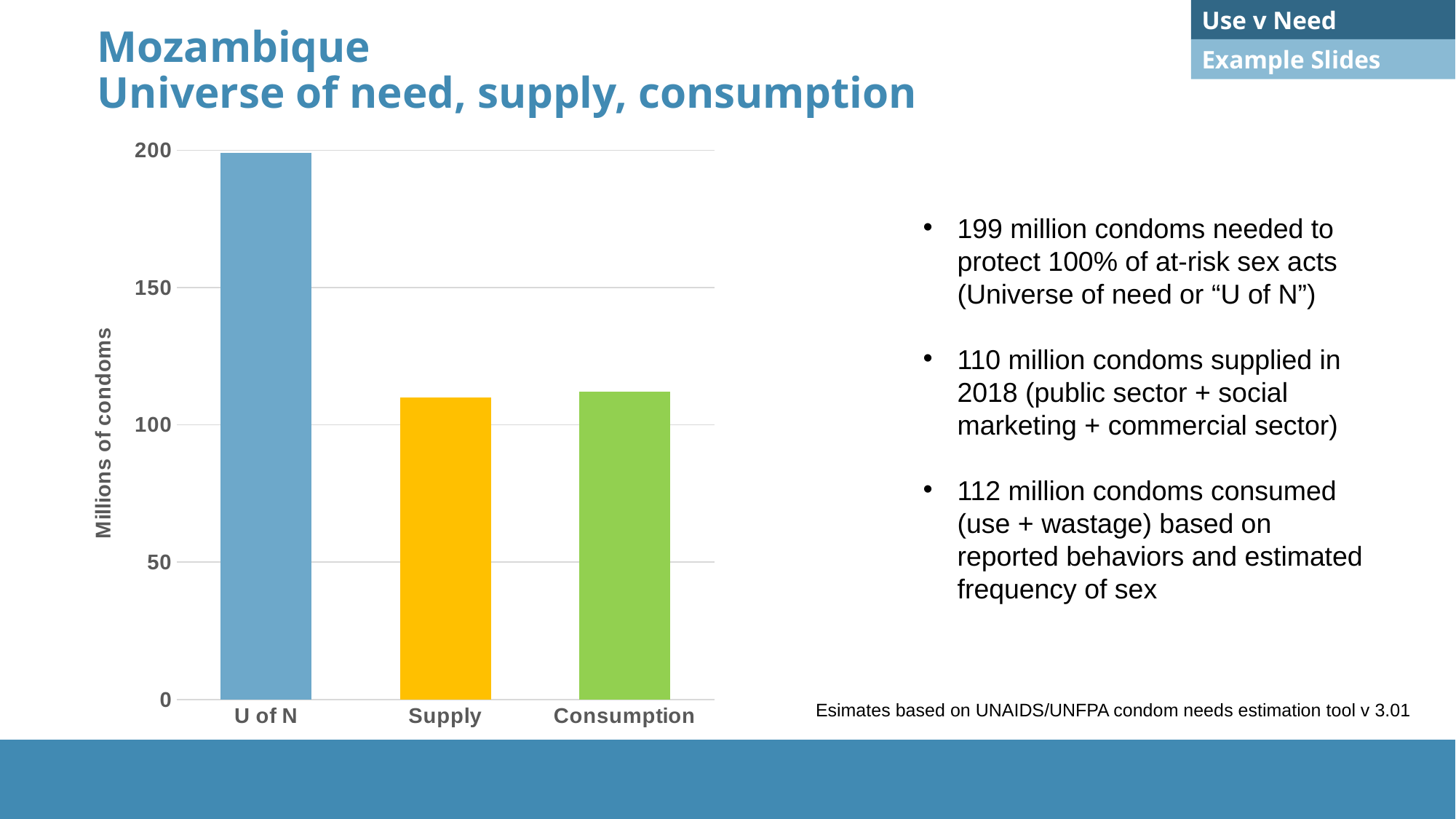
According to the slide, how many million condoms were supplied in 2018? 110 million What is the label of the y axis of the chart? Millions of condoms How many categories are shown on the x axis of the chart? 3 Is the value for U of N greater or less than 150? greater According to the slide, how many million condoms were consumed? 112 million What kind of chart is shown on the slide? bar chart Is the value for Supply greater or less than 150? less According to the slide, how many million condoms are needed (U of N)? 199 million Which category has the highest bar in the chart? U of N Is the value for Consumption greater or less than 100? greater What colour is the Supply bar in the chart? yellow Which is larger, the value for U of N or the value for Supply? U of N